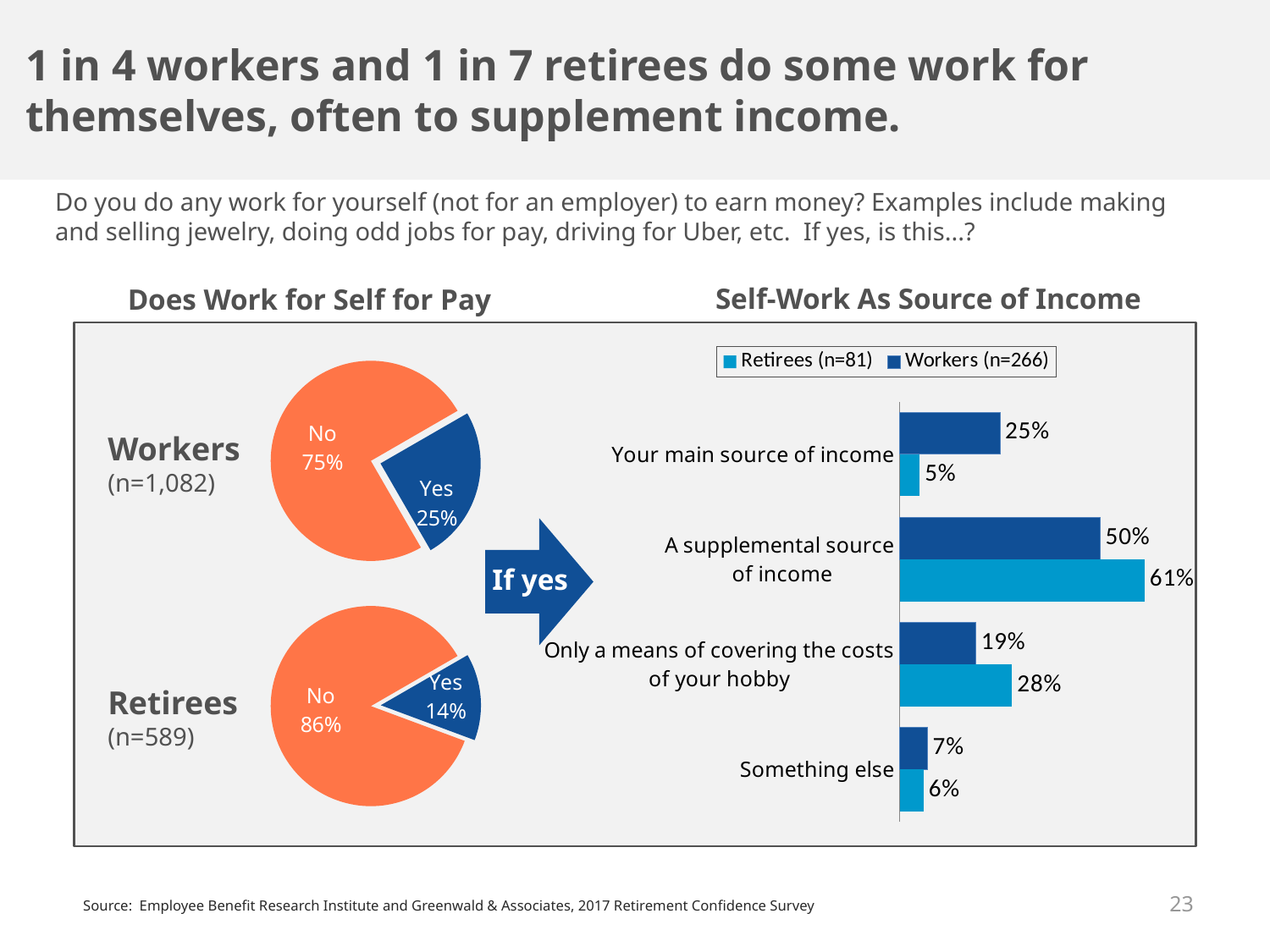
How many categories are shown in the 'Self-Work As Source of Income' chart? 4 In the Retirees pie chart, what share of the pie is the Yes slice? 14% In the 'Self-Work As Source of Income' chart, which category has the highest value for Retirees? A supplemental source of income In the 'Self-Work As Source of Income' chart, what is the value for Workers for 'A supplemental source of income'? 50% In the Retirees pie chart under 'Does Work for Self for Pay', what percentage answered No? 86% In the 'Self-Work As Source of Income' chart, what is the difference between the Retirees and Workers values for 'A supplemental source of income'? 11% How many series does the legend of the 'Self-Work As Source of Income' chart list? 2 In the 'Self-Work As Source of Income' chart, which category has the lowest value for Workers? Something else In the Workers pie chart under 'Does Work for Self for Pay', what percentage answered Yes? 25% In the 'Self-Work As Source of Income' chart, what is the value for Retirees for 'Your main source of income'? 5% What kind of chart is used for 'Self-Work As Source of Income'? Bar chart In the 'Self-Work As Source of Income' chart, which is larger for 'Only a means of covering the costs of your hobby': Workers or Retirees? Retirees